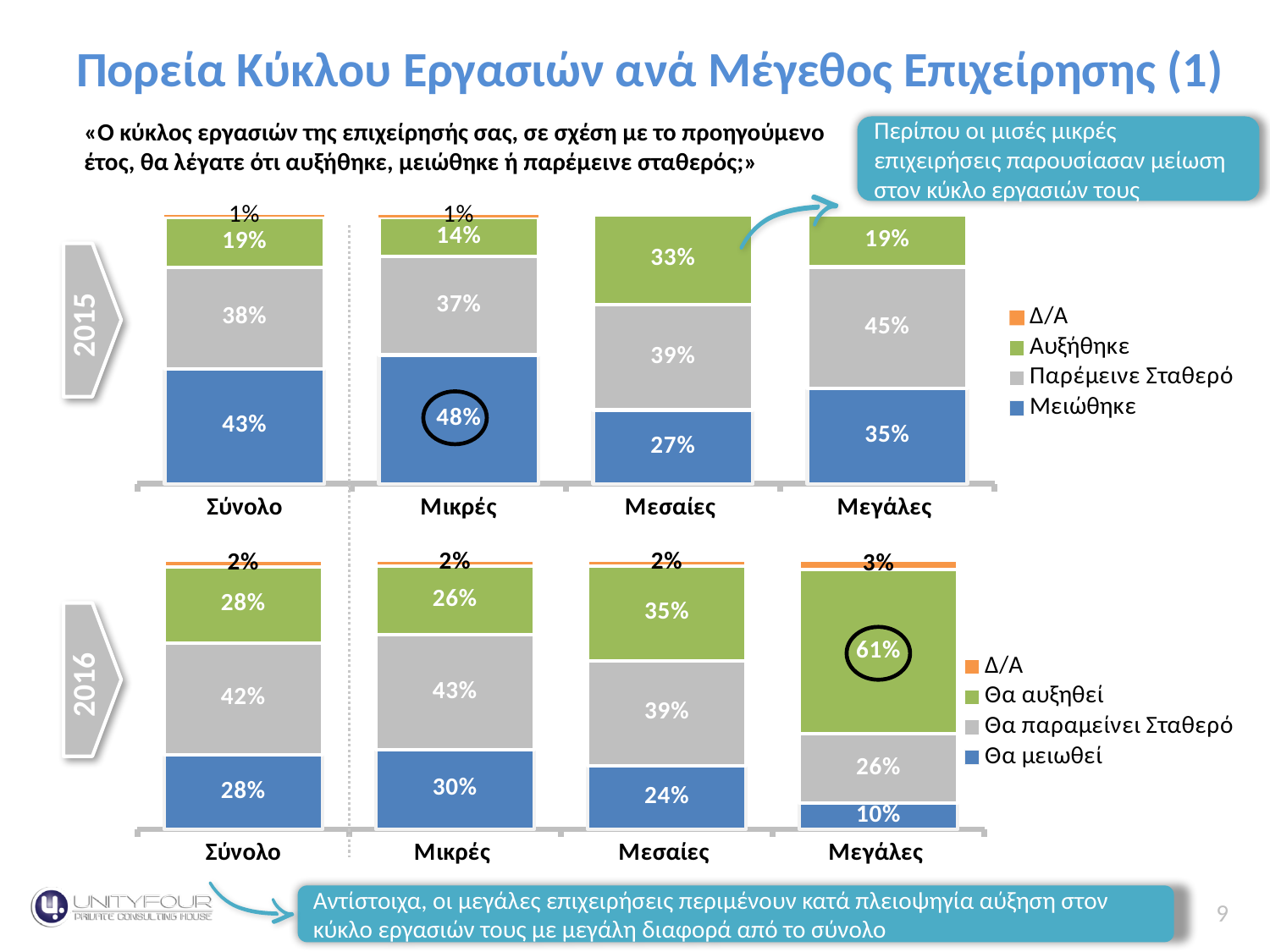
In the 2015 chart, what percentage of Μικρές businesses reported Μειώθηκε? 48% In the 2016 chart, what percentage of Μεγάλες businesses answered Θα αυξηθεί? 61% In the 2015 chart, what is the difference between the Αυξήθηκε values for Μεσαίες and Μικρές? 19 percentage points In the 2016 chart, what is the Θα μειωθεί value for Μεσαίες? 24% In the 2016 chart, which category has the lowest Θα μειωθεί value? Μεγάλες What type of chart is used for the 2015 data? Stacked bar chart How many series does the legend of the 2016 chart list? 4 In the 2015 chart, what is the Παρέμεινε Σταθερό value for Μεγάλες? 45% In the 2016 chart, what is the total of the Μεγάλες bar (Δ/Α + Θα αυξηθεί + Θα παραμείνει Σταθερό + Θα μειωθεί)? 100% In the 2015 chart, which category has the highest Μειώθηκε value? Μικρές In the 2016 chart, which is larger for Σύνολο: Θα αυξηθεί or Θα μειωθεί? They are equal (28%) How many categories are shown on the x axis of the 2015 chart? 4